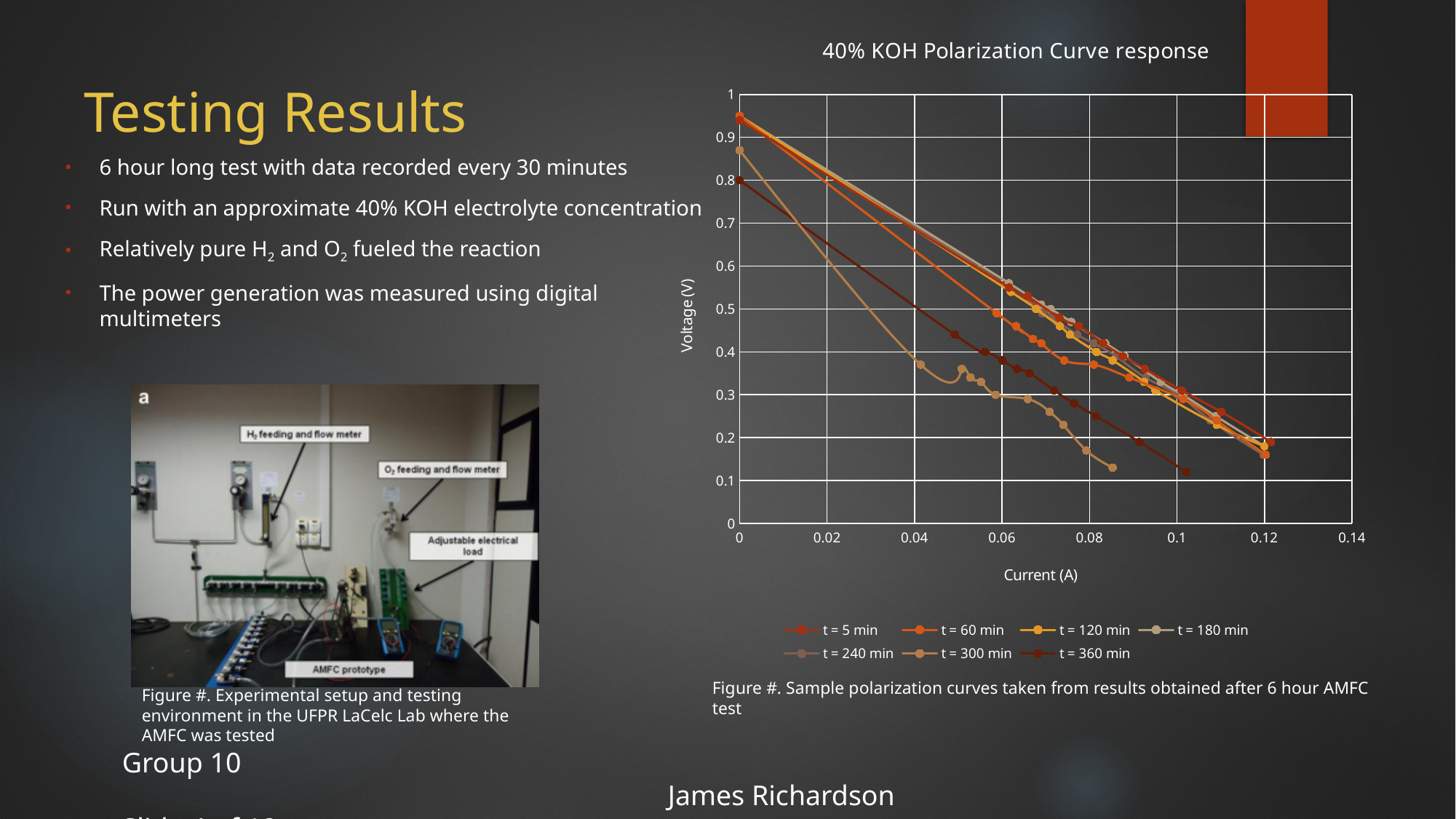
What is the largest value shown on the current axis? 0.14 As current increases along the x axis, do the plotted voltage values rise or fall? fall Which series in the legend corresponds to the earliest time? t = 5 min Is the voltage of the t = 5 min series at a current of 0.1 A greater or less than 0.4? less Is the highest voltage plotted at a current of 0 A greater or less than 0.9? greater What is the label of the vertical axis of the chart? Voltage (V) Is the lowest voltage value plotted on the chart greater or less than 0.2? less What is the title of the chart? 40% KOH Polarization Curve response What is the largest value shown on the voltage axis? 1 How many series does the legend of the chart list? 7 What kind of chart is shown on the slide? line chart